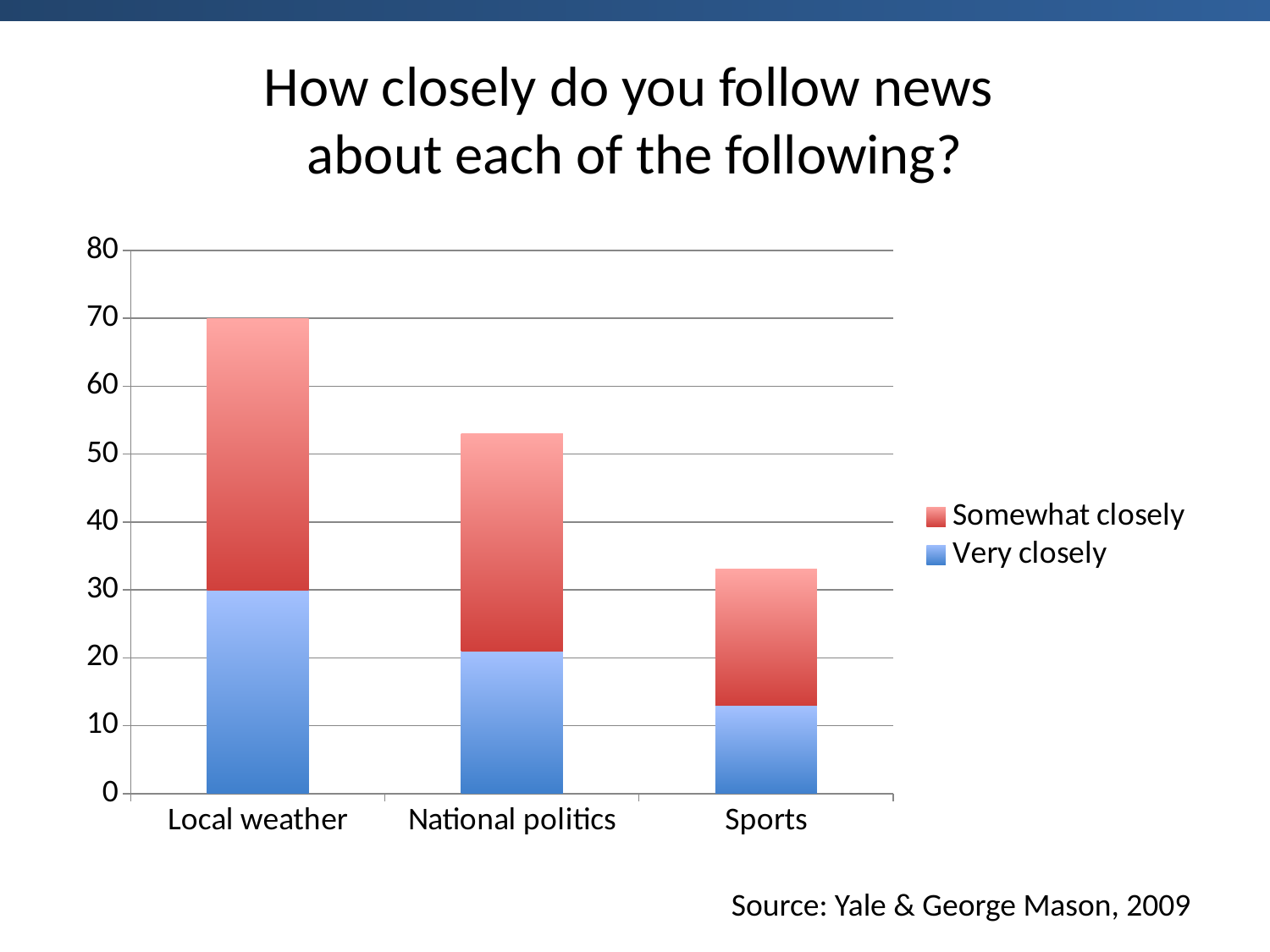
Is the total stacked bar for National politics greater or less than 50? greater What is the 'Very closely' value for Local weather? 30 Is the total stacked bar for Sports greater or less than 40? less What is the total height of the stacked bar for Local weather? 70 Which category has the shortest stacked bar? Sports Which has a larger total bar, National politics or Sports? National politics How many categories are shown on the x axis? 3 Which category has the tallest stacked bar? Local weather Do the total bar heights rise or fall from Local weather to Sports along the x axis? fall How many series does the legend list? 2 What kind of chart is shown on the slide? Stacked bar chart Is the 'Very closely' value for Sports greater or less than 10? greater